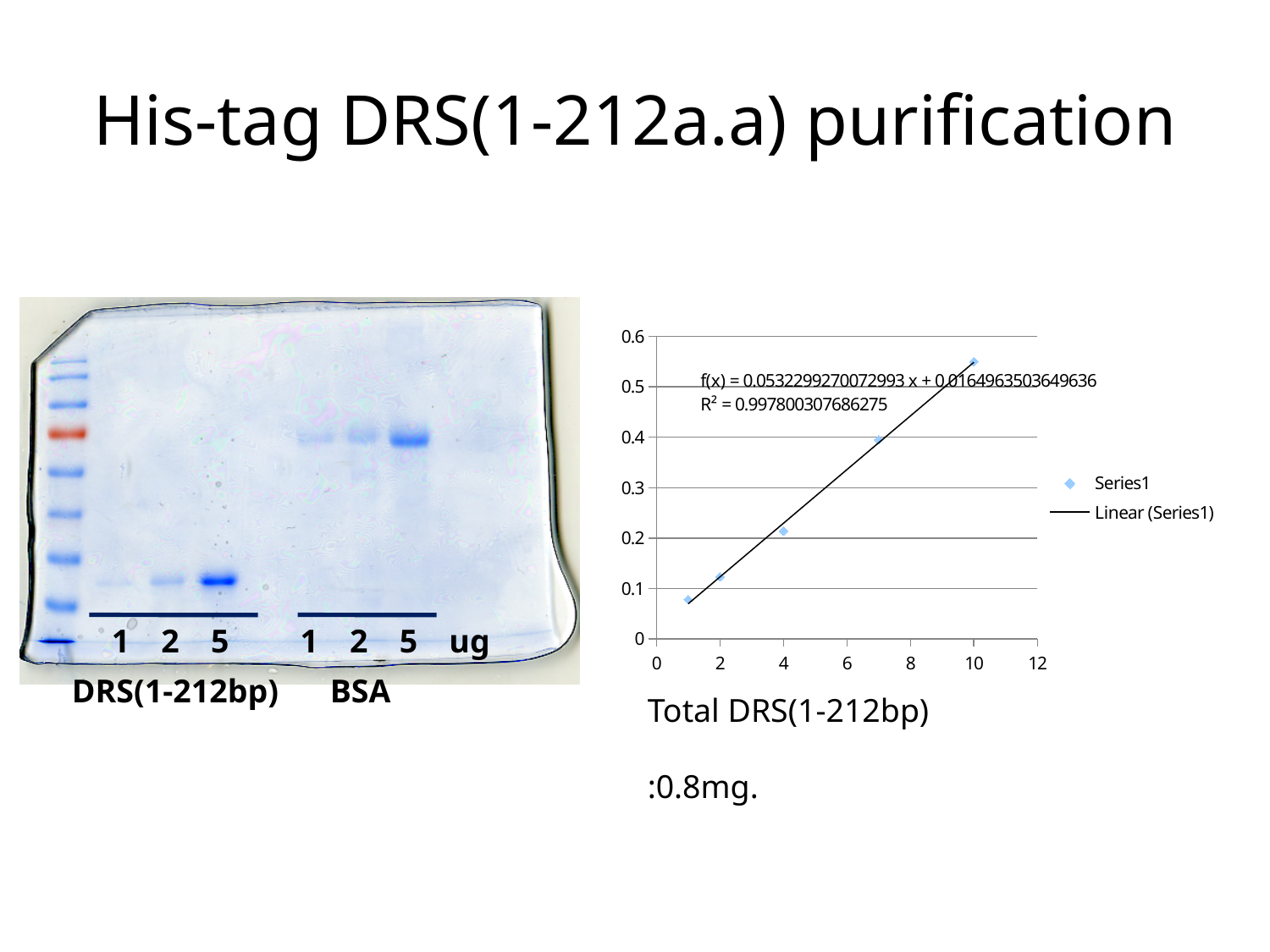
Which plotted point in the scatter chart has the lowest y value? the point at x = 1 What R² value is printed on the scatter chart for the linear fit? 0.997800307686275 Which plotted point in the scatter chart has the highest y value? the point at x = 10 Is the y value of the point at x = 10 greater or less than 0.5? greater Which has the larger y value in the scatter chart, the point at x = 2 or the point at x = 7? the point at x = 7 How many data points are plotted in the scatter chart? 5 How many entries does the legend of the scatter chart list? 2 Is the y value of the point at x = 4 greater or less than 0.3? less Is the y value of the point at x = 7 greater or less than 0.3? greater Do the plotted values in the scatter chart rise or fall as x increases? rise What kind of chart is shown on the right side of the slide? scatter chart